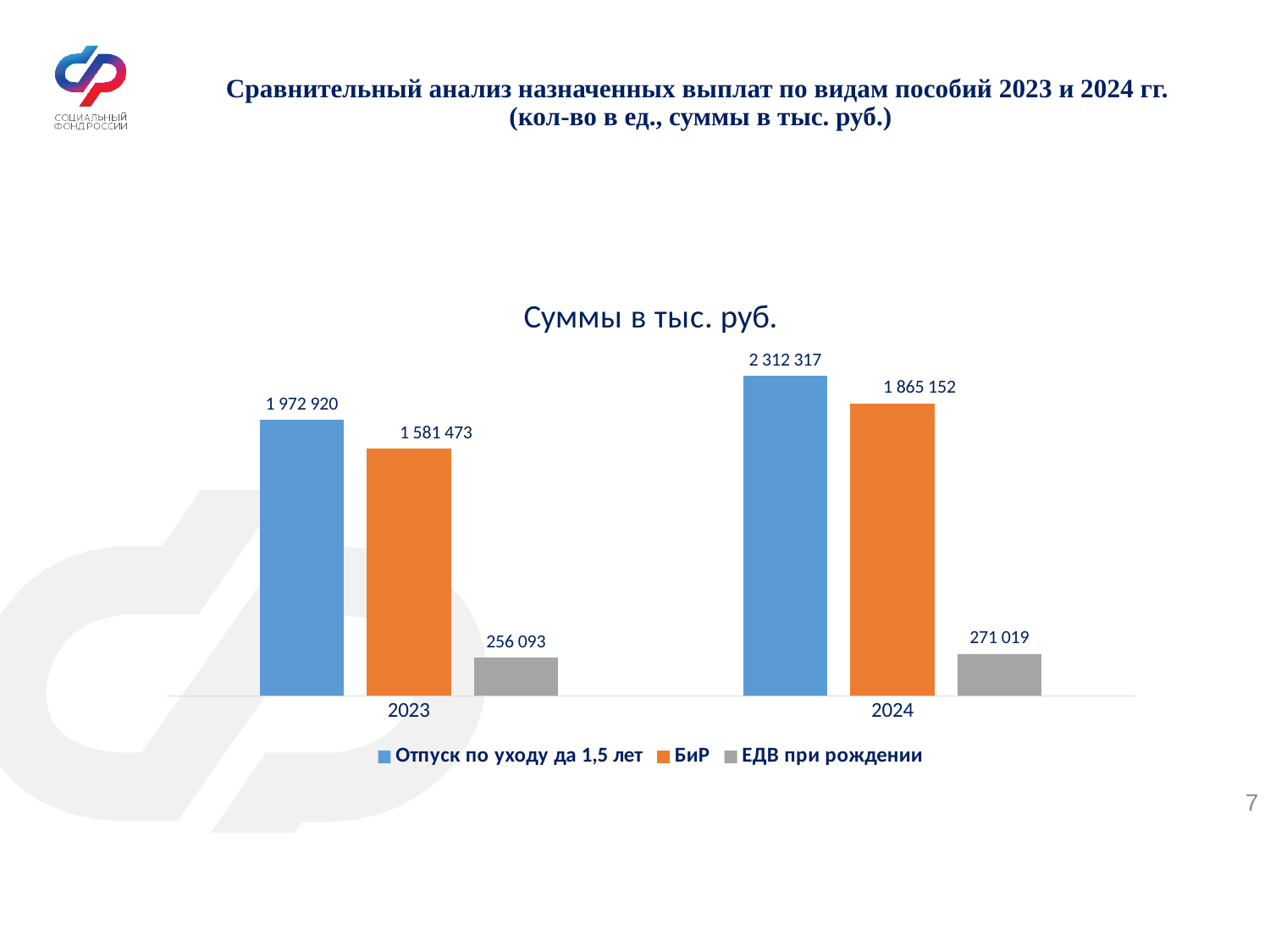
What is the title of the chart? Суммы в тыс. руб. By how much did the value for Отпуск по уходу да 1,5 лет increase from 2023 to 2024? 339 397 Which is larger: БиР in 2023 or БиР in 2024? БиР in 2024 How many series does the legend list? 3 Which series has the highest value in 2024? Отпуск по уходу да 1,5 лет What is the value for Отпуск по уходу да 1,5 лет in 2024? 2 312 317 Which series has the lowest value in 2023? ЕДВ при рождении What is the difference between ЕДВ при рождении in 2024 and in 2023? 14 926 What is the value for ЕДВ при рождении in 2023? 256 093 What is the value for Отпуск по уходу да 1,5 лет in 2023? 1 972 920 What kind of chart is shown on the slide? Bar chart What is the value for БиР in 2024? 1 865 152